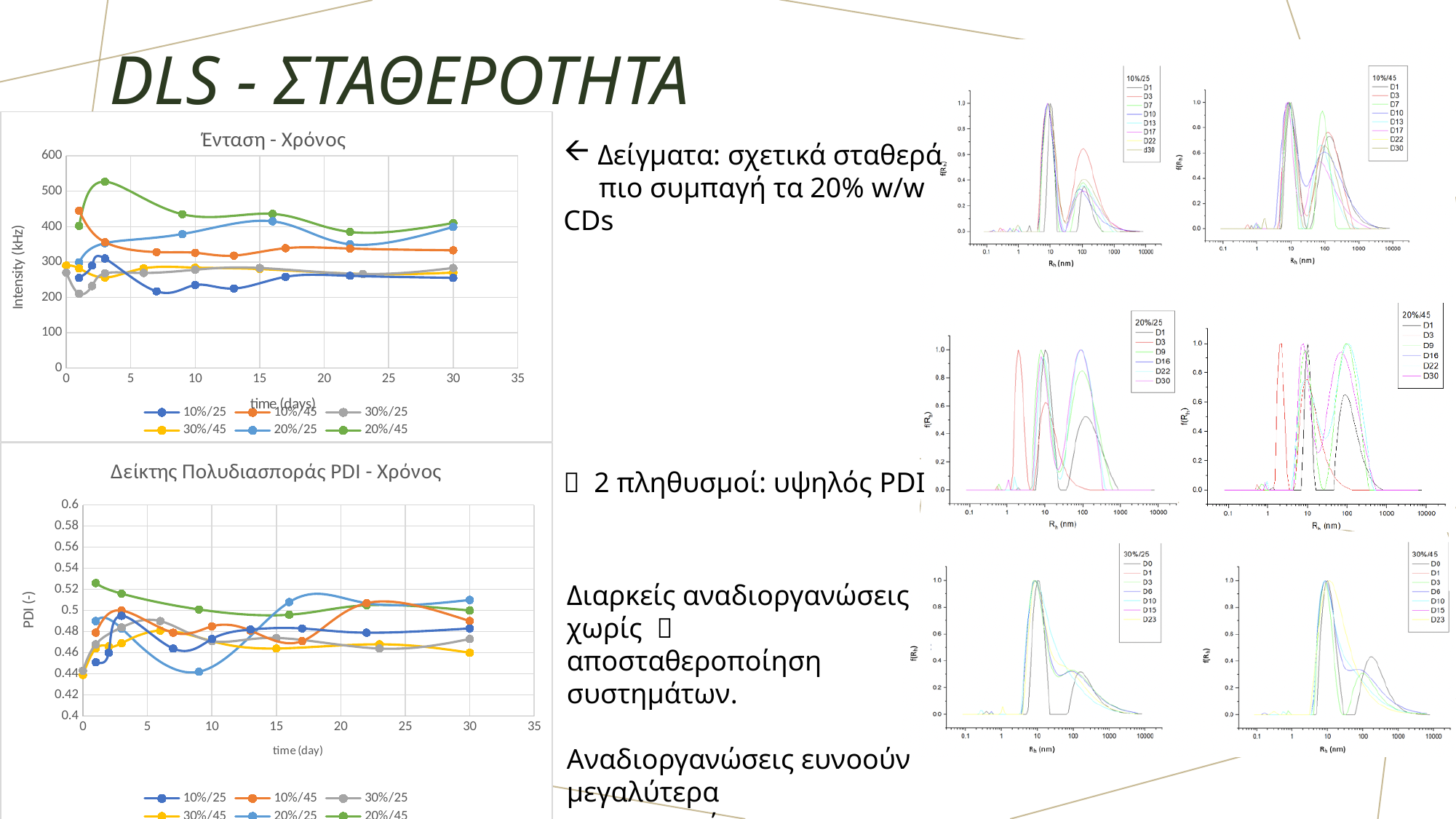
In the 'Δείκτης Πολυδιασποράς PDI - Χρόνος' chart, is the value of the 20%/25 series at day 9 greater or less than 0.46? less What kind of chart is the 'Ένταση - Χρόνος' chart? line chart In the 'Ένταση - Χρόνος' chart, which series reaches the highest intensity value? 20%/45 What is the y-axis label of the 'Ένταση - Χρόνος' chart? Intensity (kHz) What kind of chart is the 'Δείκτης Πολυδιασποράς PDI - Χρόνος' chart? line chart How many series does the legend of the 'Ένταση - Χρόνος' chart list? 6 In the 'Ένταση - Χρόνος' chart, which series has the higher value at day 30: 20%/45 or 10%/25? 20%/45 In the 'Ένταση - Χρόνος' chart, is the value of the 10%/25 series at day 7 greater or less than 300? less What is the y-axis label of the 'Δείκτης Πολυδιασποράς PDI - Χρόνος' chart? PDI (-) In the 'Ένταση - Χρόνος' chart, does the 10%/45 series rise or fall between day 1 and day 3? fall In the 'Ένταση - Χρόνος' chart, is the peak value of the 20%/45 series greater or less than 500? greater